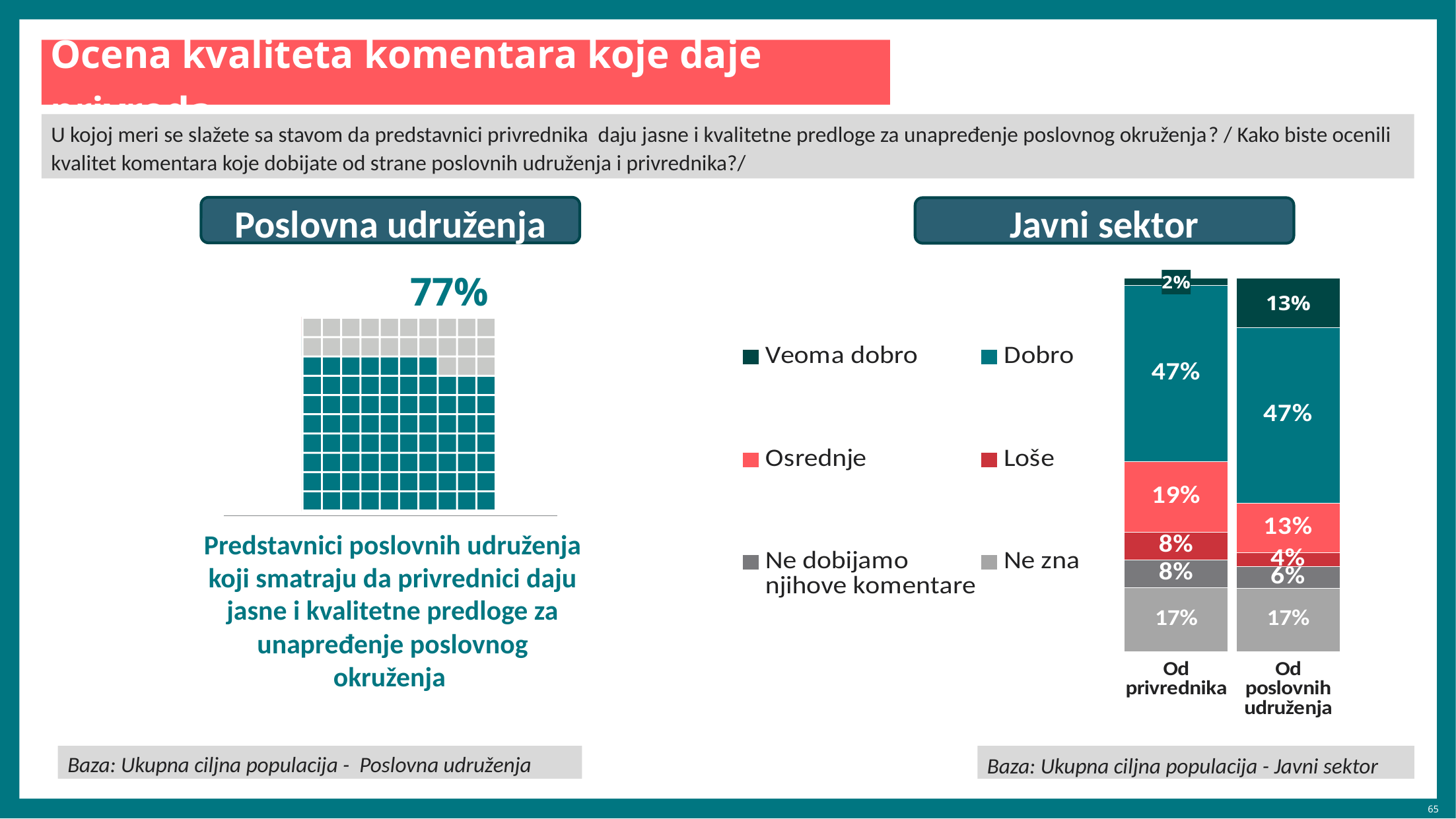
In the Javni sektor chart, what is the difference between the 'Veoma dobro' values for 'Od poslovnih udruženja' and 'Od privrednika'? 11% In the Javni sektor chart, what is the 'Osrednje' value for 'Od privrednika'? 19% In the Javni sektor chart, what percentage of the 'Od privrednika' bar is 'Dobro'? 47% In the Javni sektor chart, how many series does the legend list? 6 In the Javni sektor chart, what is the 'Ne zna' value for 'Od privrednika'? 17% In the Poslovna udruženja chart, what percentage of representatives think that businesses give clear and quality proposals? 77% In the Javni sektor chart, which bar has the larger 'Osrednje' value, 'Od privrednika' or 'Od poslovnih udruženja'? Od privrednika In the Javni sektor chart, how many bars are plotted? 2 What kind of chart is shown under Javni sektor? Stacked bar chart In the Javni sektor chart, what is the 'Loše' value for 'Od poslovnih udruženja'? 4% In the Javni sektor chart, which category is the largest segment in the 'Od poslovnih udruženja' bar? Dobro In the Javni sektor chart, what is the 'Veoma dobro' value for 'Od poslovnih udruženja'? 13%